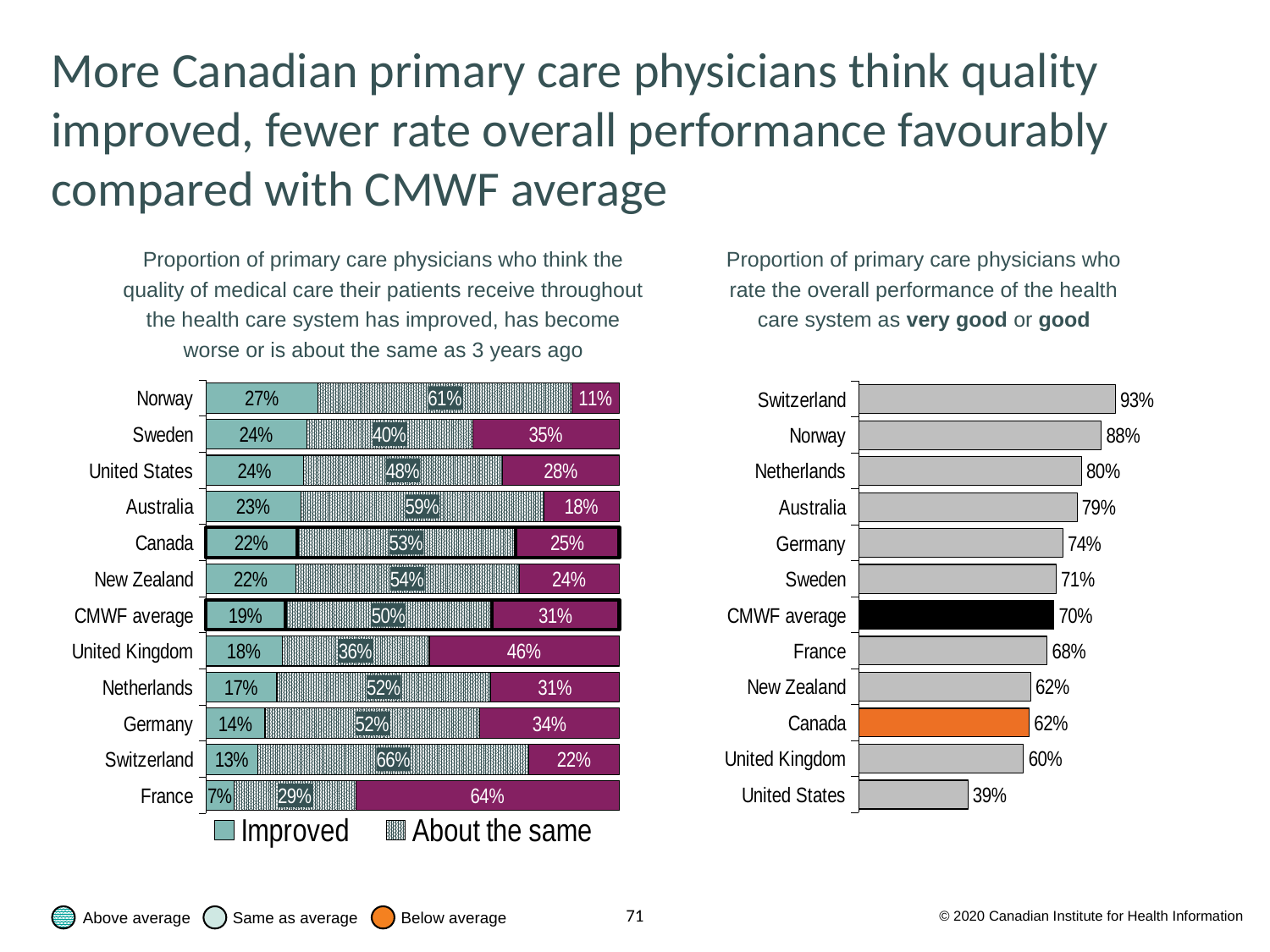
In the right chart, what is the difference between Switzerland's value and the United States' value? 54 percentage points In the right chart, what proportion of Canadian primary care physicians rate the overall performance of the health system as very good or good? 62% In the left chart, what proportion of physicians in France think the quality of care is about the same as 3 years ago? 29% In the left chart, how many percentage points higher is Canada's 'Improved' share than the CMWF average's 'Improved' share? 3 percentage points In the right chart, what is the value shown for the CMWF average? 70% In the left chart, what proportion of Canadian primary care physicians think the quality of care has improved? 22% What kind of chart is the right chart? Bar chart How many countries or groups are listed in the left chart? 12 In the left chart, which has a larger 'Improved' share, Norway or Germany? Norway In the right chart, which country has the highest proportion of physicians rating overall performance as very good or good? Switzerland In the right chart, which has a higher value, Germany or Sweden? Germany In the right chart, which country has the lowest proportion of physicians rating overall performance as very good or good? United States